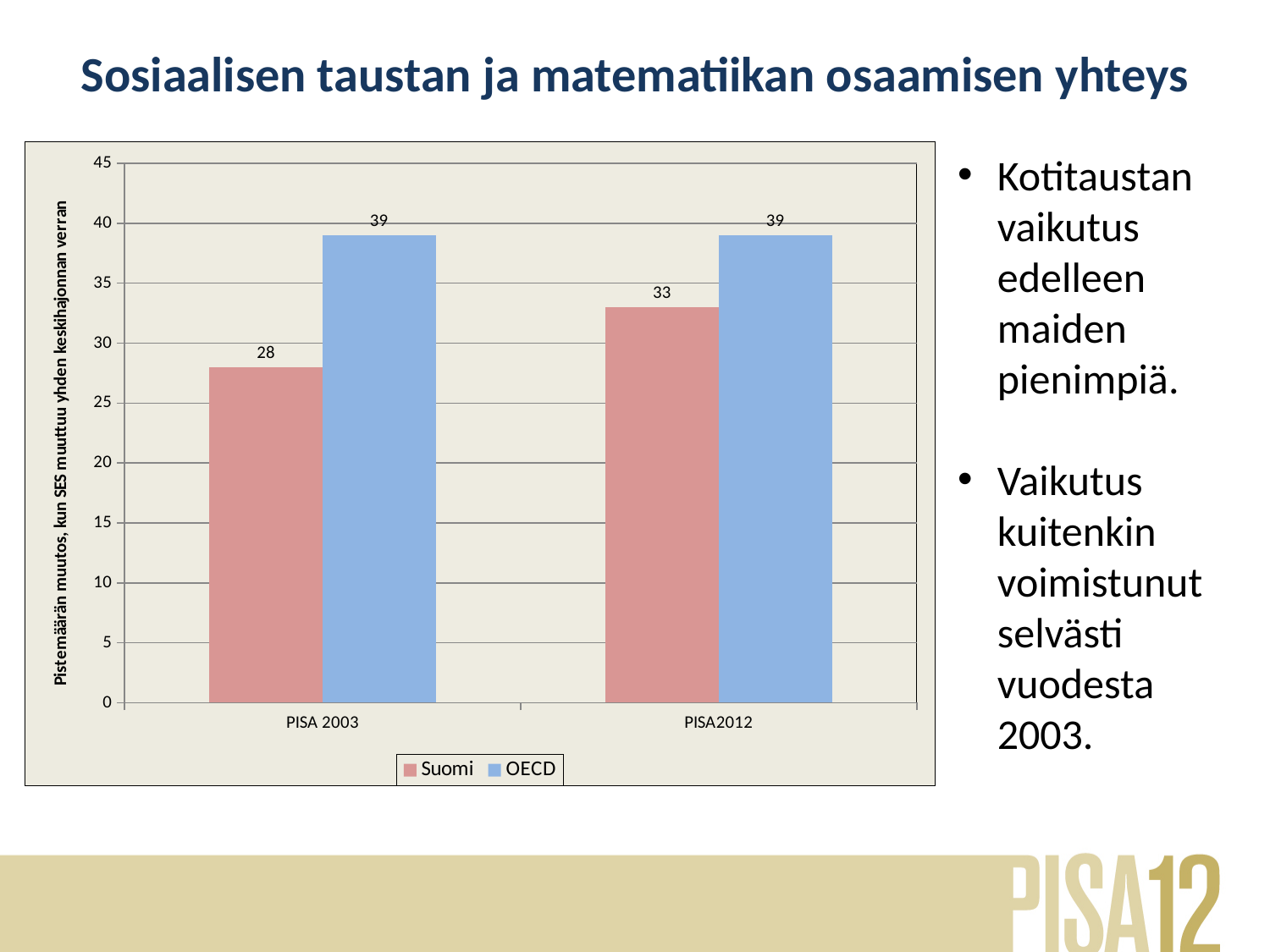
What is the value for Suomi in PISA 2003? 28 What is the value for OECD in PISA 2003? 39 Which series has the higher value in PISA 2003, Suomi or OECD? OECD What is the difference between the OECD and Suomi values in PISA2012? 6 Does the Suomi value rise or fall from PISA 2003 to PISA2012? rise By how much did the Suomi value change from PISA 2003 to PISA2012? 5 How many series does the legend list? 2 What is the difference between the OECD and Suomi values in PISA 2003? 11 What kind of chart is shown on the slide? bar chart What is the value for OECD in PISA2012? 39 What is the value for Suomi in PISA2012? 33 How many categories are shown on the x axis? 2